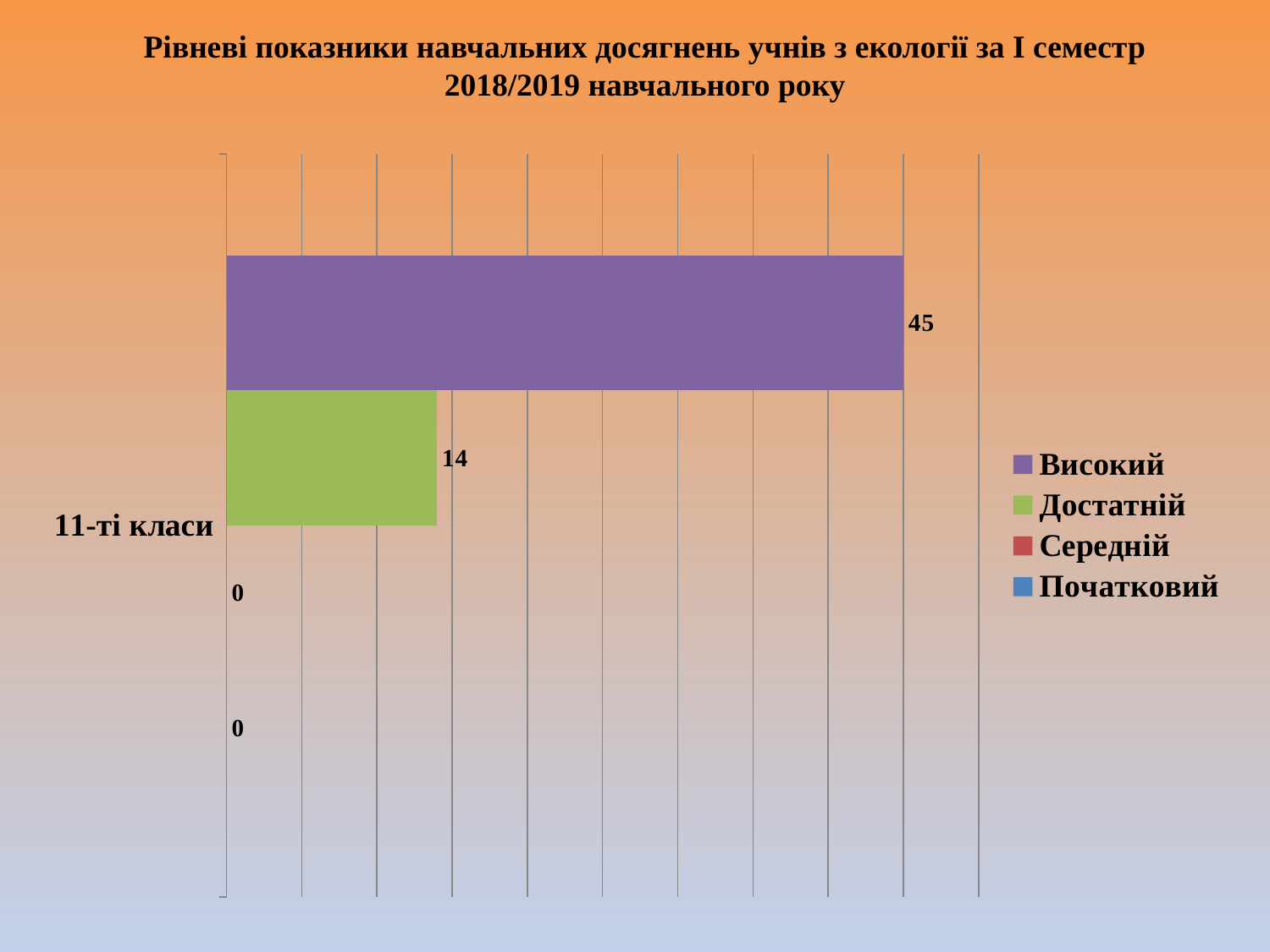
What is the value for Достатній for 11-ті класи? 14 What is the value for Високий for 11-ті класи? 45 What is the value for Початковий for 11-ті класи? 0 What is the value for Середній for 11-ті класи? 0 What is the difference between the Високий and Достатній values for 11-ті класи? 31 How many series does the legend list? 4 Which colour represents the Достатній series in the legend? Green How many categories are shown on the category axis? 1 Which series has the highest value for 11-ті класи? Високий Which is larger for 11-ті класи, Високий or Достатній? Високий What kind of chart is shown on the slide? Bar chart What is the total of all four series values for 11-ті класи? 59